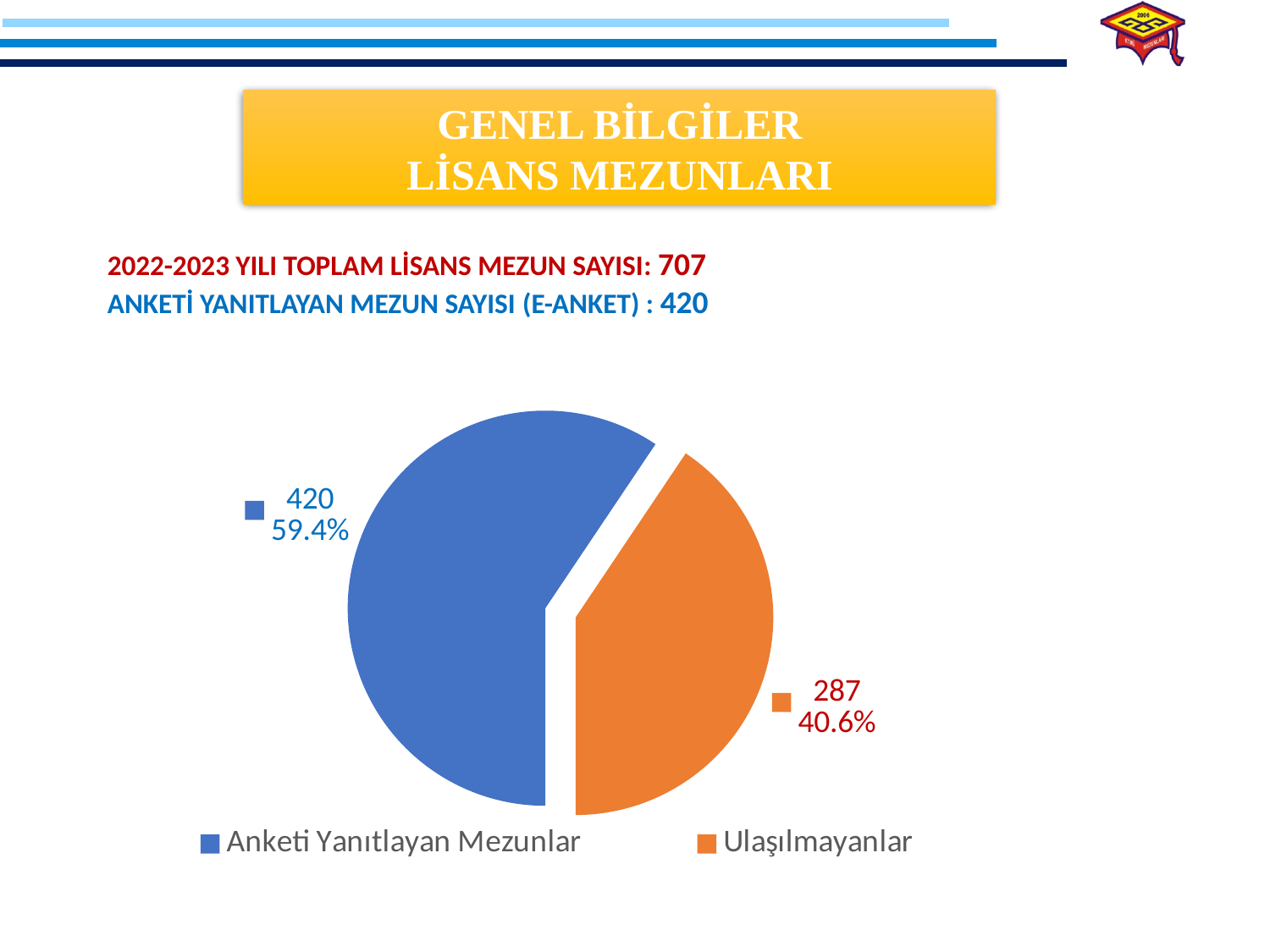
Which slice is the largest? Anketi Yanıtlayan Mezunlar What kind of chart is shown on the slide? pie chart What is the value for Anketi Yanıtlayan Mezunlar? 420 What is the difference between the values for Anketi Yanıtlayan Mezunlar and Ulaşılmayanlar? 133 What is the total of the two slices in the pie chart? 707 Which is larger, Anketi Yanıtlayan Mezunlar or Ulaşılmayanlar? Anketi Yanıtlayan Mezunlar Which slice is the smallest? Ulaşılmayanlar What share of the pie does Ulaşılmayanlar represent? 40.6% What share of the pie does Anketi Yanıtlayan Mezunlar represent? 59.4% What colour is the Ulaşılmayanlar slice? orange How many slices does the pie chart have? 2 What is the value for Ulaşılmayanlar? 287